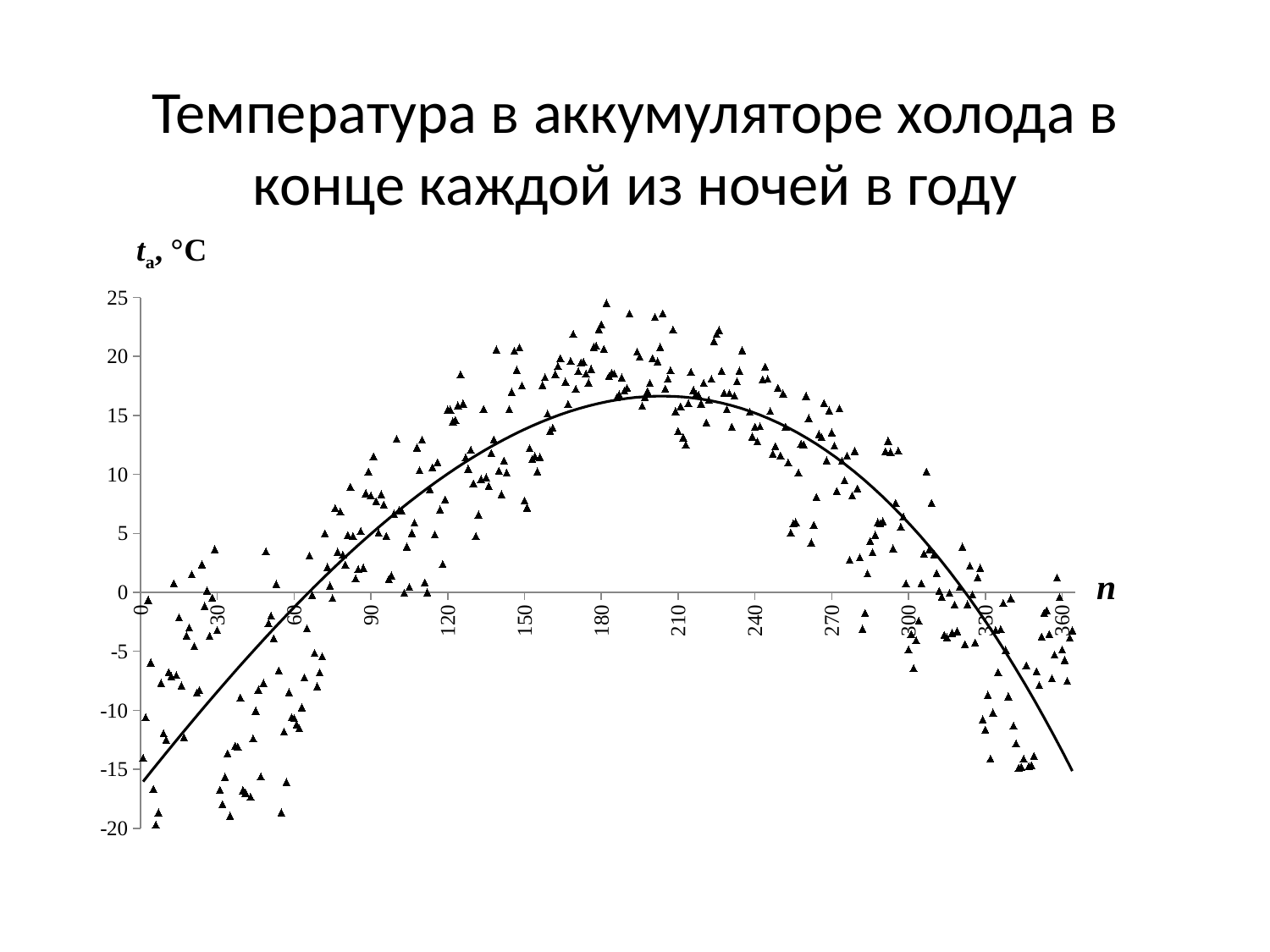
Is the value of the fitted curve at n = 180 greater or less than 15? greater Does the fitted curve rise or fall between n = 210 and n = 360? fall Is the value of the fitted curve at n = 360 greater or less than -10? less What is the title of the chart? Температура в аккумуляторе холода в конце каждой из ночей в году What label is shown on the vertical axis of the chart? ta, °C What is the highest value shown on the vertical axis? 25 Is the value of the fitted curve at n = 30 greater or less than -5? less Does the fitted curve rise or fall between n = 0 and n = 180? rise What kind of chart is shown on the slide? scatter chart